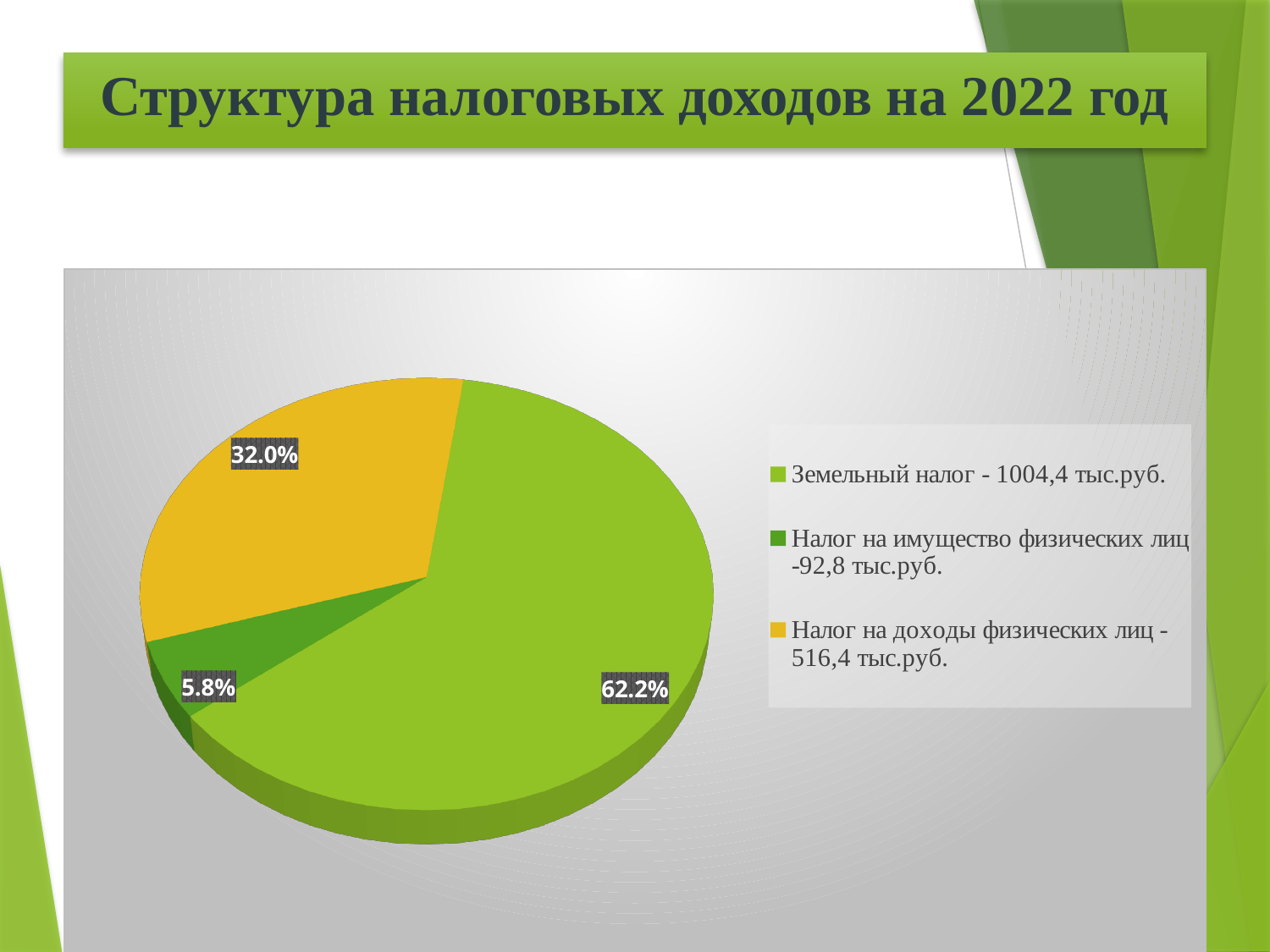
What share of the pie does Налог на доходы физических лиц have? 32.0% What colour is the slice for Налог на доходы физических лиц? yellow What is the difference in percentage points between the share for Налог на доходы физических лиц and the share for Налог на имущество физических лиц? 26.2 What is the difference in percentage points between the share for Земельный налог and the share for Налог на доходы физических лиц? 30.2 What kind of chart is shown on the slide? pie chart What share of the pie does Налог на имущество физических лиц have? 5.8% Which category has the smallest slice of the pie? Налог на имущество физических лиц Which category has the largest slice of the pie? Земельный налог Which is larger: the share for Земельный налог or the share for Налог на доходы физических лиц? Земельный налог What share of the pie does Земельный налог have? 62.2% How many slices does the pie chart have? 3 What is the title of the slide containing the chart? Структура налоговых доходов на 2022 год